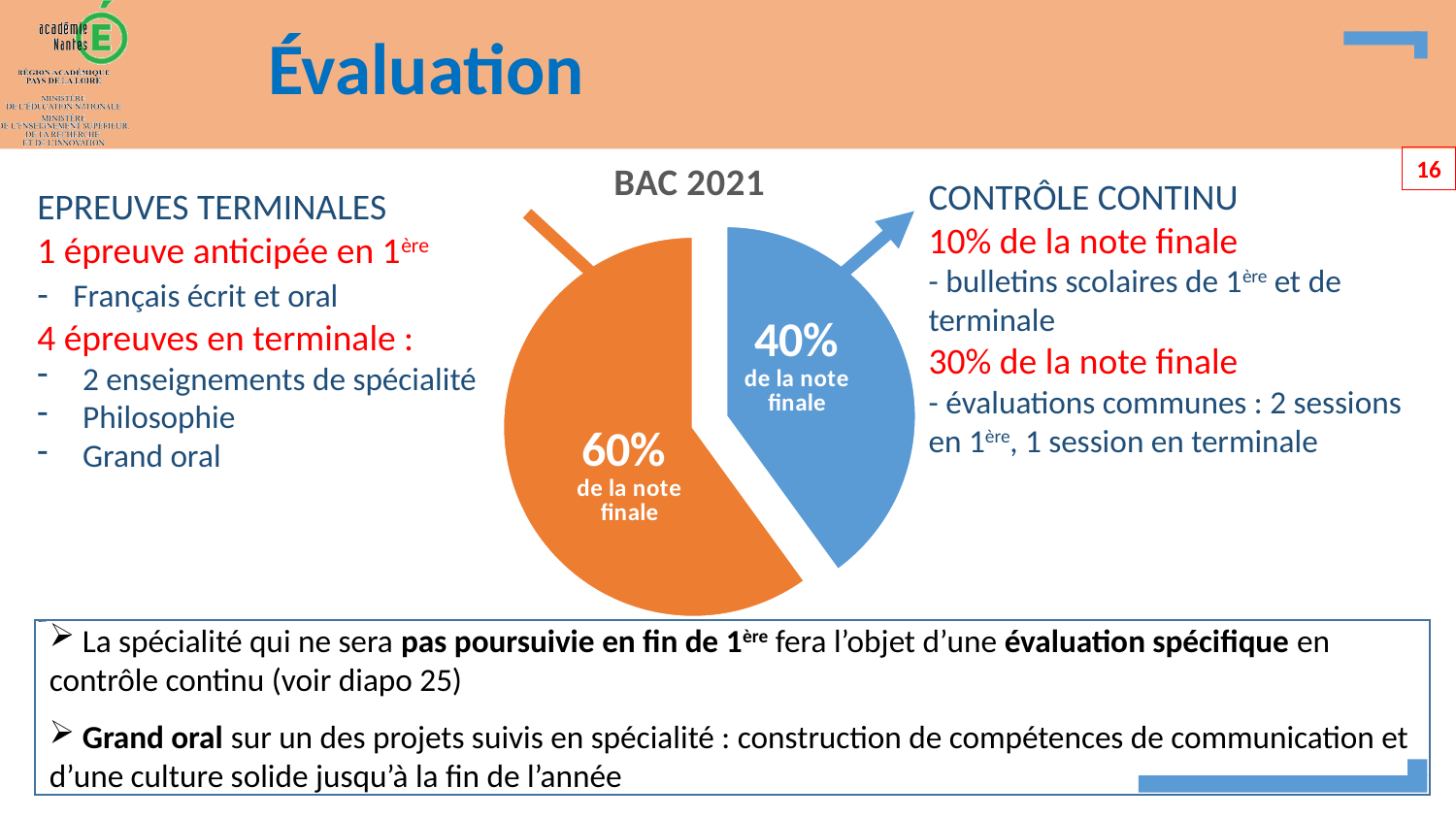
What percentage is shown on the blue slice of the pie chart? 40% What share of the pie does the blue slice represent? 40% Which slice of the pie chart is the smallest? the blue slice (40%) How many slices does the pie chart have? 2 What kind of chart is shown on the slide? pie chart What text appears under the percentage on each slice of the pie chart? de la note finale What is the difference in percentage points between the orange slice and the blue slice? 20 Which slice of the pie chart is the largest? the orange slice (60%) What is the title of the chart? BAC 2021 What percentage is shown on the orange slice of the pie chart? 60% Which is larger, the orange slice or the blue slice? the orange slice Is the value of the orange slice greater or less than 50%? greater